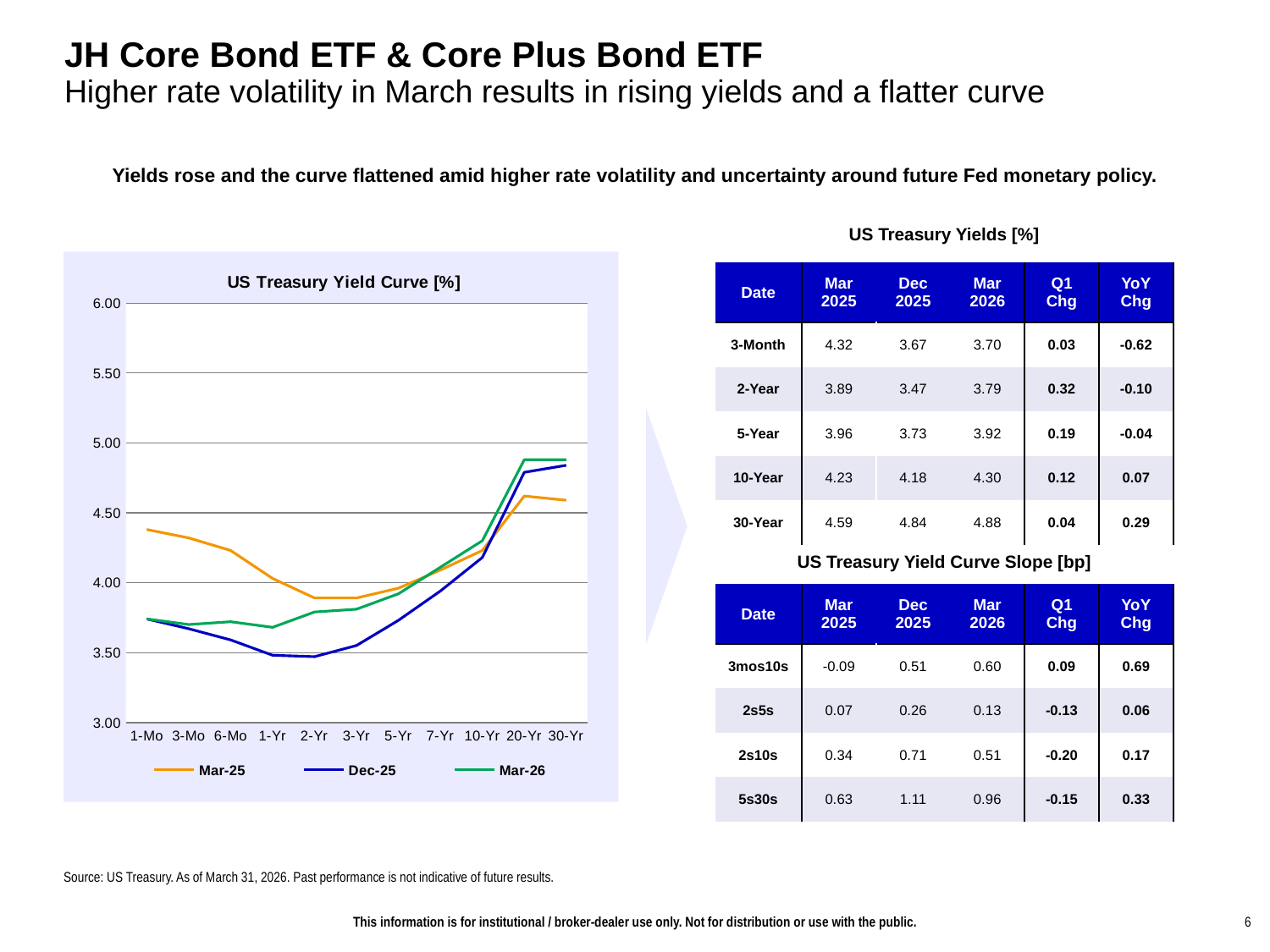
Which series is drawn in orange in the chart? Mar-25 Is the Mar-25 value at 1-Mo greater or less than 4.00? greater Does the Dec-25 series rise or fall from 2-Yr to 30-Yr? rise Is the Mar-26 value at 1-Mo greater or less than 4.00? less At 30-Yr, which series has the higher value, Mar-25 or Mar-26? Mar-26 Is the Mar-26 value at 30-Yr greater or less than 4.50? greater How many series does the chart's legend list? 3 How many maturity points are shown along the x axis of the chart? 11 What kind of chart is shown on the slide? line chart What is the title of the chart on the slide? US Treasury Yield Curve [%] At 1-Mo, which series has the higher value, Mar-25 or Mar-26? Mar-25